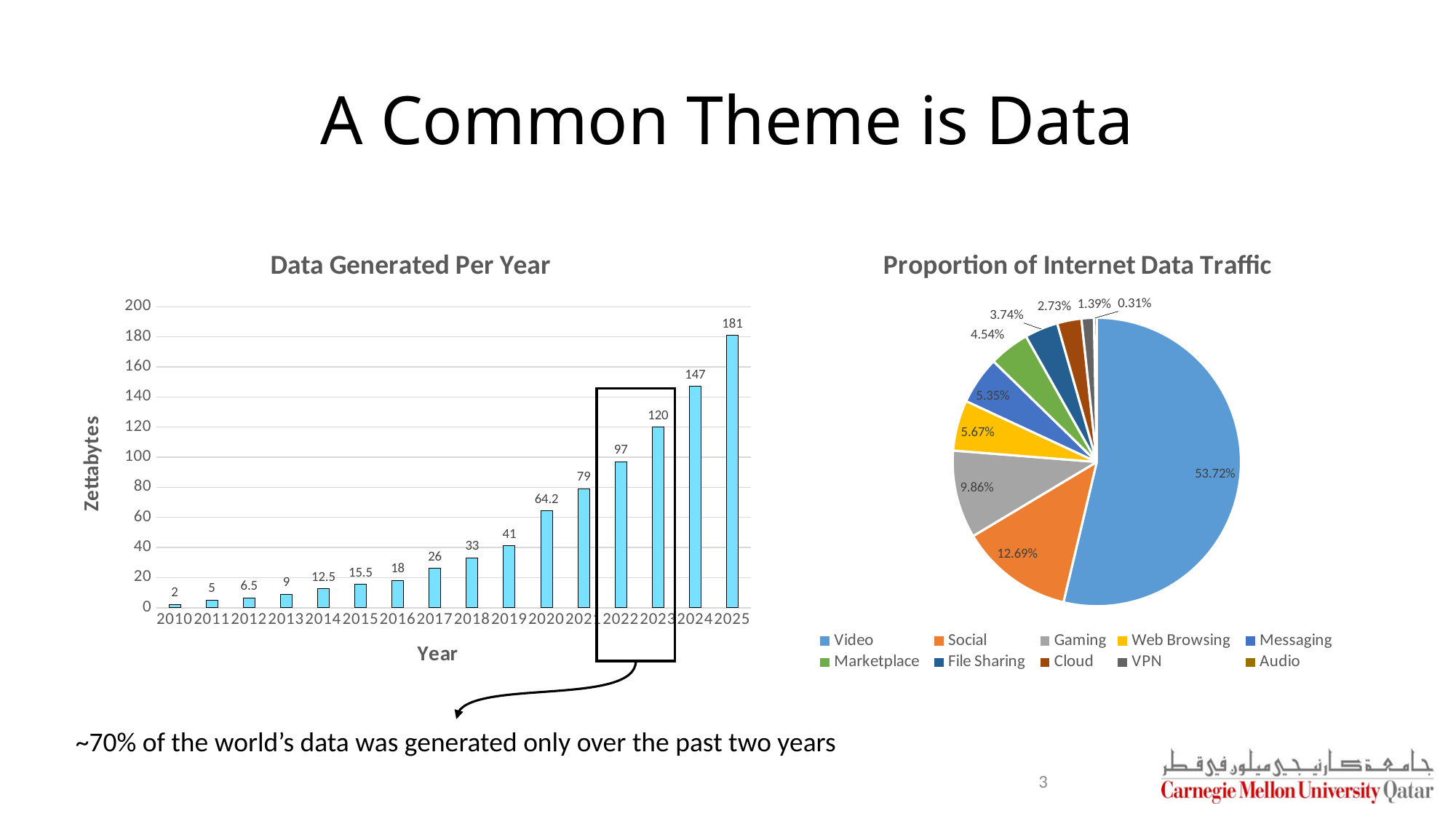
In the 'Data Generated Per Year' chart, what is the value for 2025? 181 In the 'Proportion of Internet Data Traffic' chart, which category has the smallest share? Audio In the 'Proportion of Internet Data Traffic' chart, which is larger, Social or Web Browsing? Social In the 'Proportion of Internet Data Traffic' chart, what share does Video have? 53.72% In the 'Data Generated Per Year' chart, how many years are shown on the x axis? 16 What kind of chart is 'Data Generated Per Year'? bar chart In the 'Data Generated Per Year' chart, what is the value for 2020? 64.2 In the 'Proportion of Internet Data Traffic' chart, how many categories does the legend list? 10 In the 'Data Generated Per Year' chart, do the values rise or fall from 2010 to 2025? rise In the 'Proportion of Internet Data Traffic' chart, what share does Gaming have? 9.86% In the 'Data Generated Per Year' chart, which year has the lowest value? 2010 In the 'Data Generated Per Year' chart, what is the difference between the values for 2023 and 2022? 23